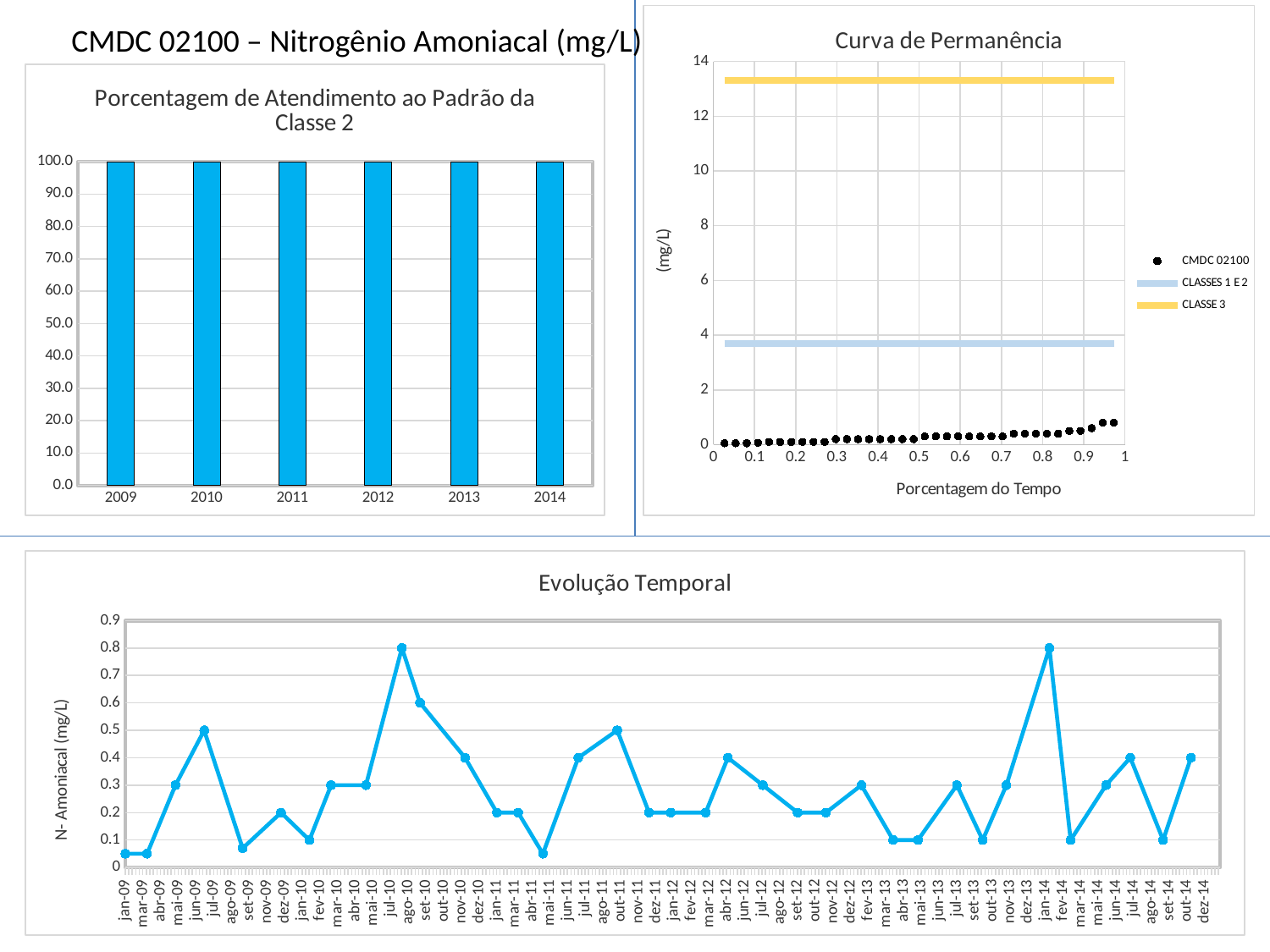
In the chart titled "Curva de Permanência", how many series does the legend list? 3 In the chart titled "Porcentagem de Atendimento ao Padrão da Classe 2", what kind of chart is shown? bar chart In the chart titled "Curva de Permanência", what is the label of the x axis? Porcentagem do Tempo In the chart titled "Evolução Temporal", what kind of chart is shown? line chart In the chart titled "Porcentagem de Atendimento ao Padrão da Classe 2", what is the value for 2012? 100.0 In the chart titled "Evolução Temporal", what is the value for jul-10? 0.8 In the chart titled "Porcentagem de Atendimento ao Padrão da Classe 2", is the value for 2009 greater or less than 50.0? greater In the chart titled "Curva de Permanência", is the CLASSE 3 line greater or less than 12 mg/L? greater In the chart titled "Evolução Temporal", what is the value for ago-10? 0.6 In the chart titled "Evolução Temporal", which is larger, the value for jan-14 or the value for mar-14? jan-14 In the chart titled "Porcentagem de Atendimento ao Padrão da Classe 2", how many years are shown on the x axis? 6 In the chart titled "Curva de Permanência", is the CLASSES 1 E 2 line greater or less than 6 mg/L? less